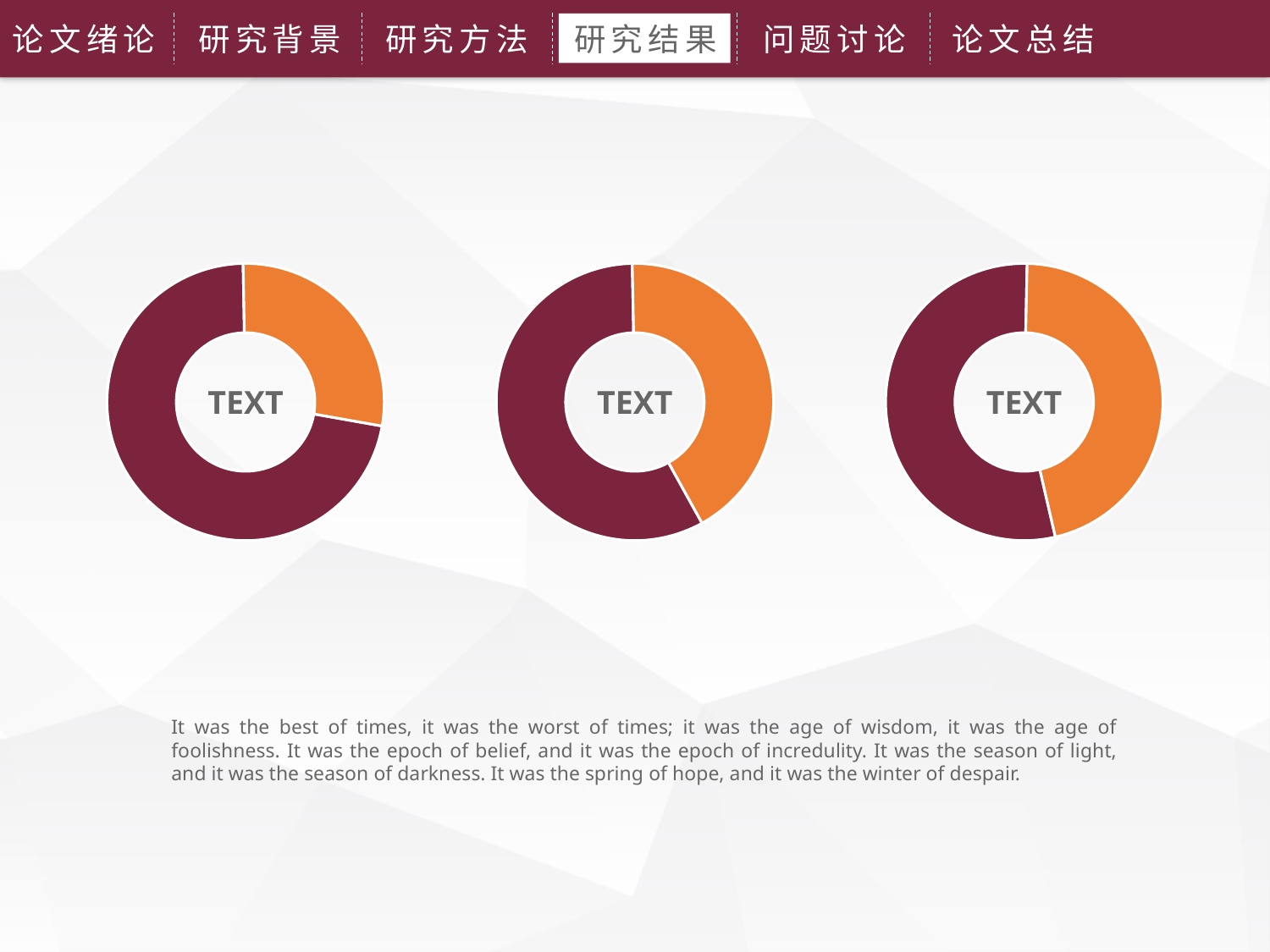
What kind of chart is the middle chart on the slide? Doughnut chart How many slices does the leftmost doughnut chart have? 2 How many slices does the rightmost doughnut chart have? 2 In the leftmost doughnut chart, which slice is larger, the dark red one or the orange one? The dark red one What text appears in the centre of each doughnut chart? TEXT How many slices does the middle doughnut chart have? 2 How many doughnut charts are shown on the slide? 3 What kind of chart is the rightmost chart on the slide? Doughnut chart What kind of chart is the leftmost chart on the slide? Doughnut chart In the middle doughnut chart, which slice is larger, the dark red one or the orange one? The dark red one